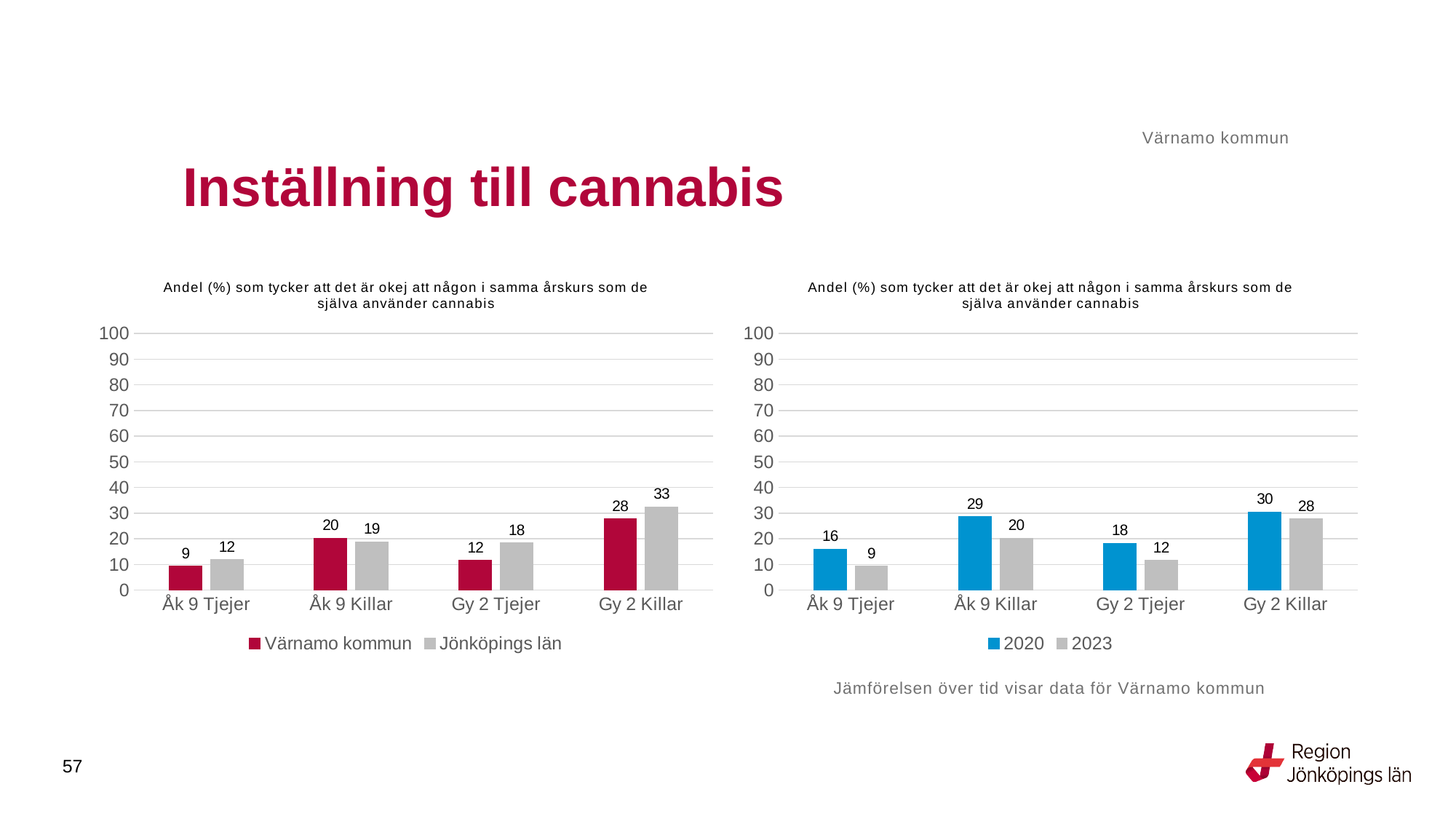
In the left chart, which category has the highest value for Jönköpings län? Gy 2 Killar How many series does the legend of the right chart list? 2 In the left chart, what is the value for Jönköpings län for Åk 9 Tjejer? 12 In the right chart, what is the value for 2020 for Åk 9 Killar? 29 In the right chart, what is the value for 2023 for Gy 2 Tjejer? 12 In the left chart, what is the difference between Jönköpings län and Värnamo kommun for Gy 2 Tjejer? 6 In the left chart, what is the value for Värnamo kommun for Gy 2 Killar? 28 In the right chart, which category has the highest value for 2020? Gy 2 Killar What kind of chart is the left chart? Bar chart In the left chart, which is larger for Åk 9 Killar: Värnamo kommun or Jönköpings län? Värnamo kommun In the left chart, which category has the lowest value for Värnamo kommun? Åk 9 Tjejer In the right chart, what is the difference between 2020 and 2023 for Åk 9 Killar? 9